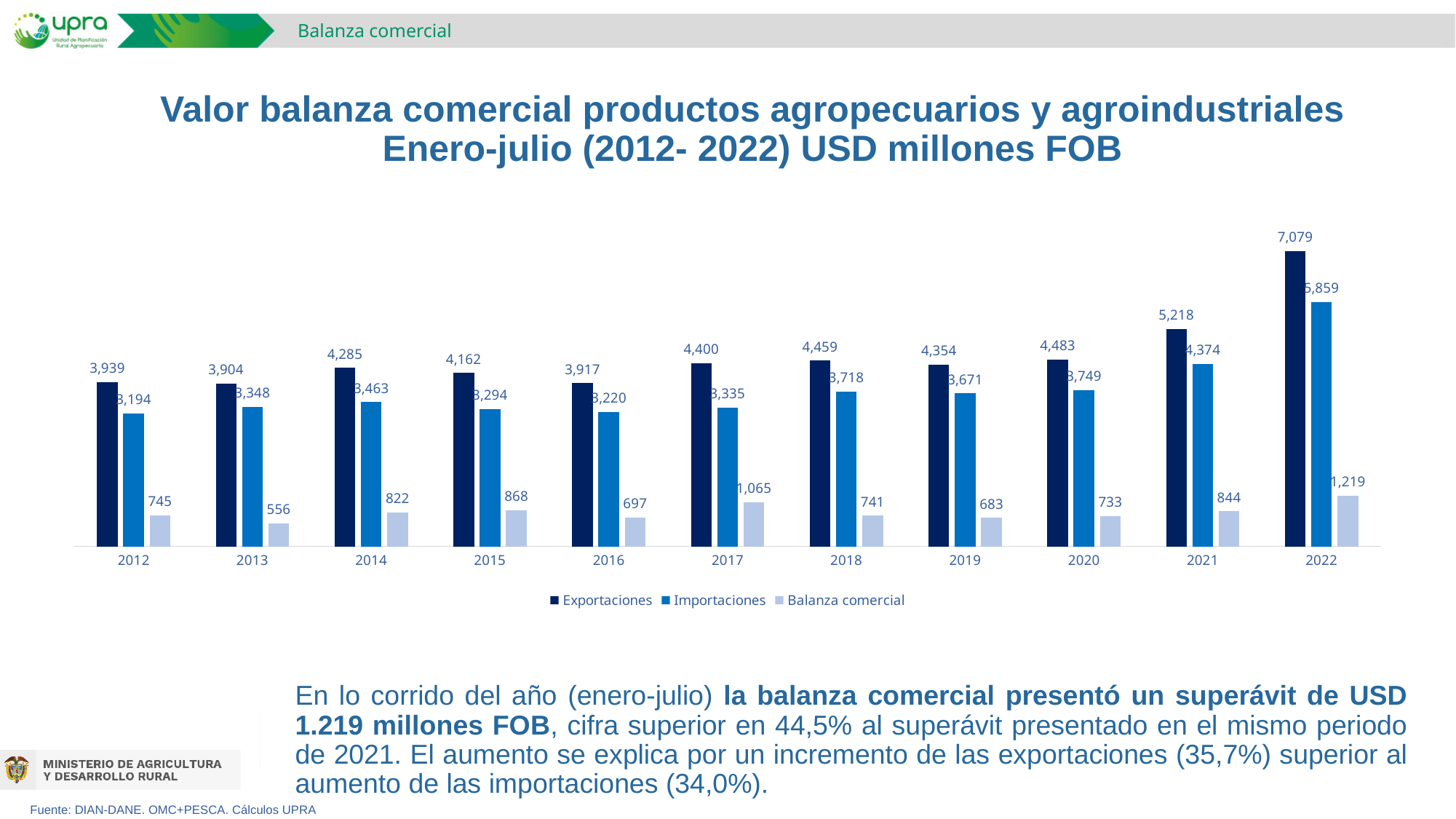
Do the Exportaciones values rise or fall from 2020 to 2022? Rise What is the value of Balanza comercial for 2017? 1,065 What kind of chart is shown on the slide? Bar chart Which year has the lowest Balanza comercial value? 2013 Which series is shown in the lightest colour in the legend? Balanza comercial What is the value of Importaciones for 2021? 4,374 How many years are shown on the x axis? 11 How many series does the legend list? 3 What is the difference between Exportaciones and Importaciones in 2022? 1,220 Which is larger, the Balanza comercial for 2014 or for 2015? 2015 Which year has the highest Exportaciones value? 2022 What is the value of Exportaciones for 2022? 7,079